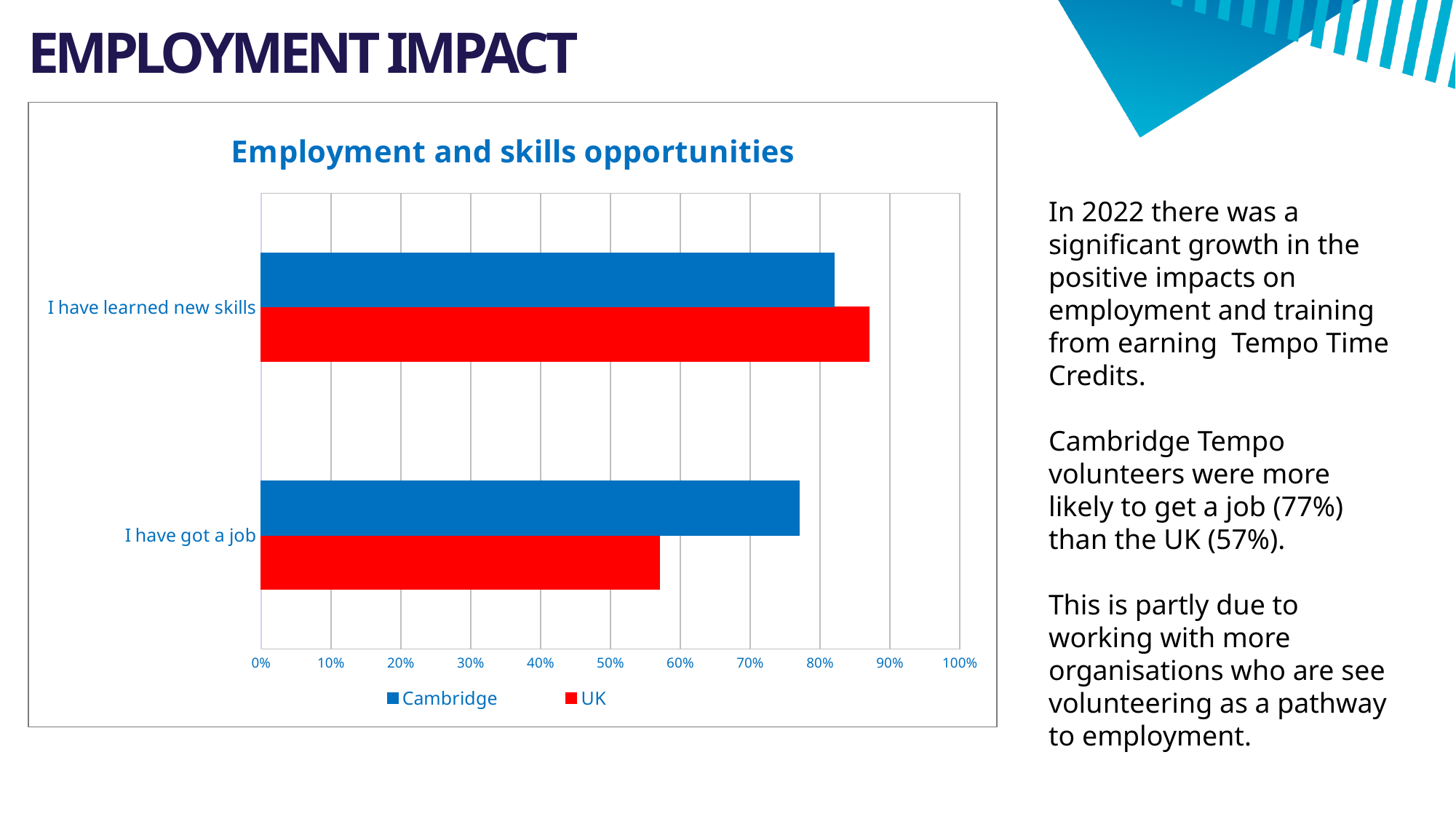
What is the Cambridge value for "I have got a job"? 77% What is the difference between the Cambridge and UK values for "I have got a job"? 20 percentage points Is the UK value for "I have learned new skills" greater or less than 80%? greater For "I have got a job", which is larger, Cambridge or UK? Cambridge Is the Cambridge value for "I have learned new skills" greater or less than 90%? less What is the title of the chart? Employment and skills opportunities How many categories are shown on the chart? 2 Which series is shown in red in the chart? UK For "I have learned new skills", which is larger, Cambridge or UK? UK What type of chart is shown on the slide? bar chart How many series does the chart legend list? 2 What is the UK value for "I have got a job"? 57%